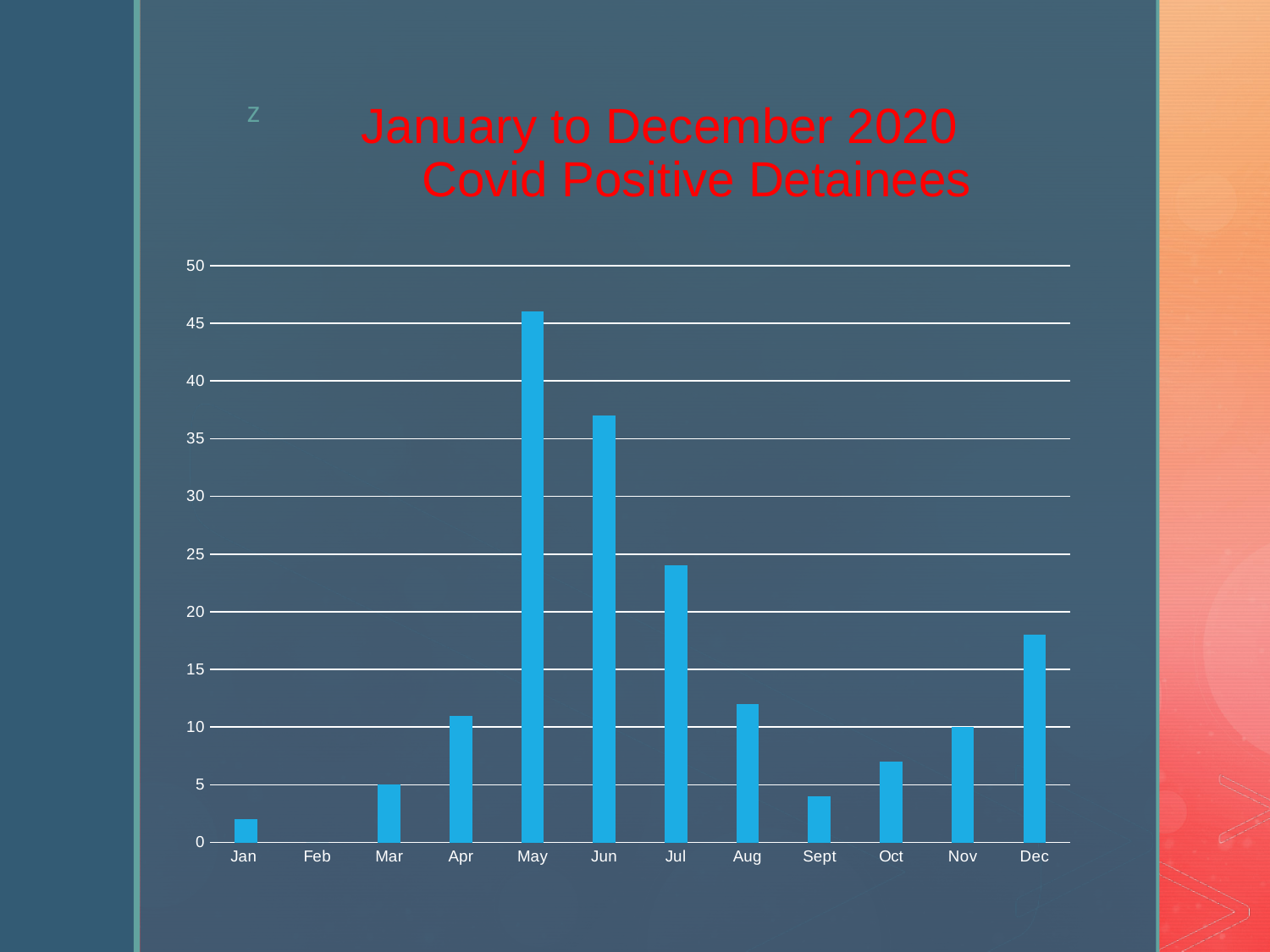
How many months are shown on the x axis of the chart? 12 Which month has a higher value, May or Jun? May What is the value for Nov? 10 Is the value for Dec greater or less than 15? greater What is the value for Mar? 5 What is the title of the chart? January to December 2020 Covid Positive Detainees Is the value for May greater or less than 45? greater Which month has the highest number of Covid positive detainees? May Which month has a higher value, Dec or Aug? Dec Which month has the lowest number of Covid positive detainees? Feb Is the value for Jun greater or less than 40? less What kind of chart is shown on the slide? Bar chart